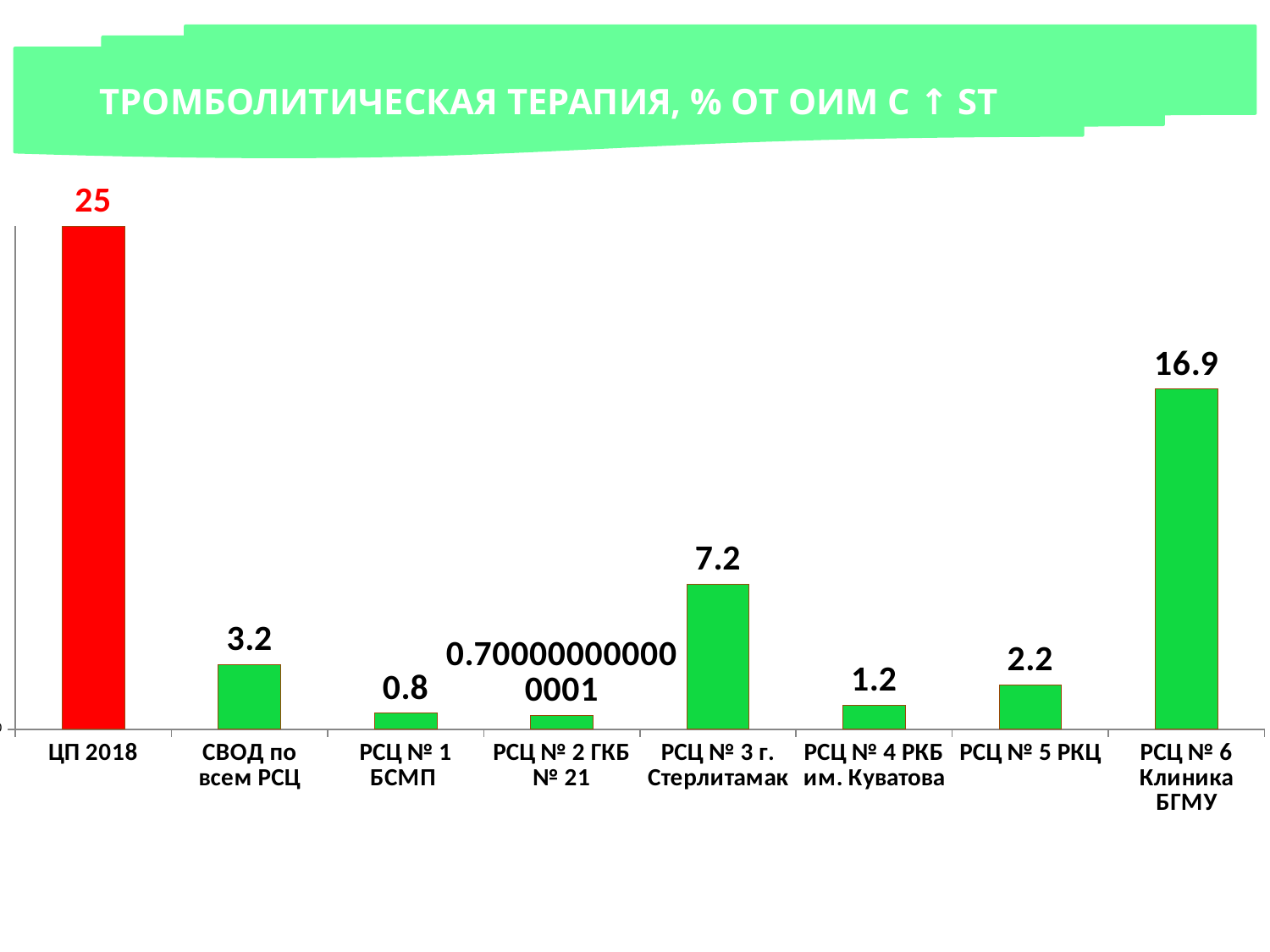
What is the value for СВОД по всем РСЦ? 3.2 What is the value for РСЦ № 3 г. Стерлитамак? 7.2 What is the value for ЦП 2018? 25 What is the value for РСЦ № 5 РКЦ? 2.2 What kind of chart is shown on the slide? Bar chart What is the difference between the values for ЦП 2018 and РСЦ № 6 Клиника БГМУ? 8.1 Which is larger, the value for РСЦ № 4 РКБ им. Куватова or the value for РСЦ № 5 РКЦ? РСЦ № 5 РКЦ What is the value for РСЦ № 6 Клиника БГМУ? 16.9 What is the difference between the values for РСЦ № 3 г. Стерлитамак and СВОД по всем РСЦ? 4 How many categories are shown on the chart? 8 Which category has the lowest value? РСЦ № 2 ГКБ № 21 Which category has the highest value? ЦП 2018